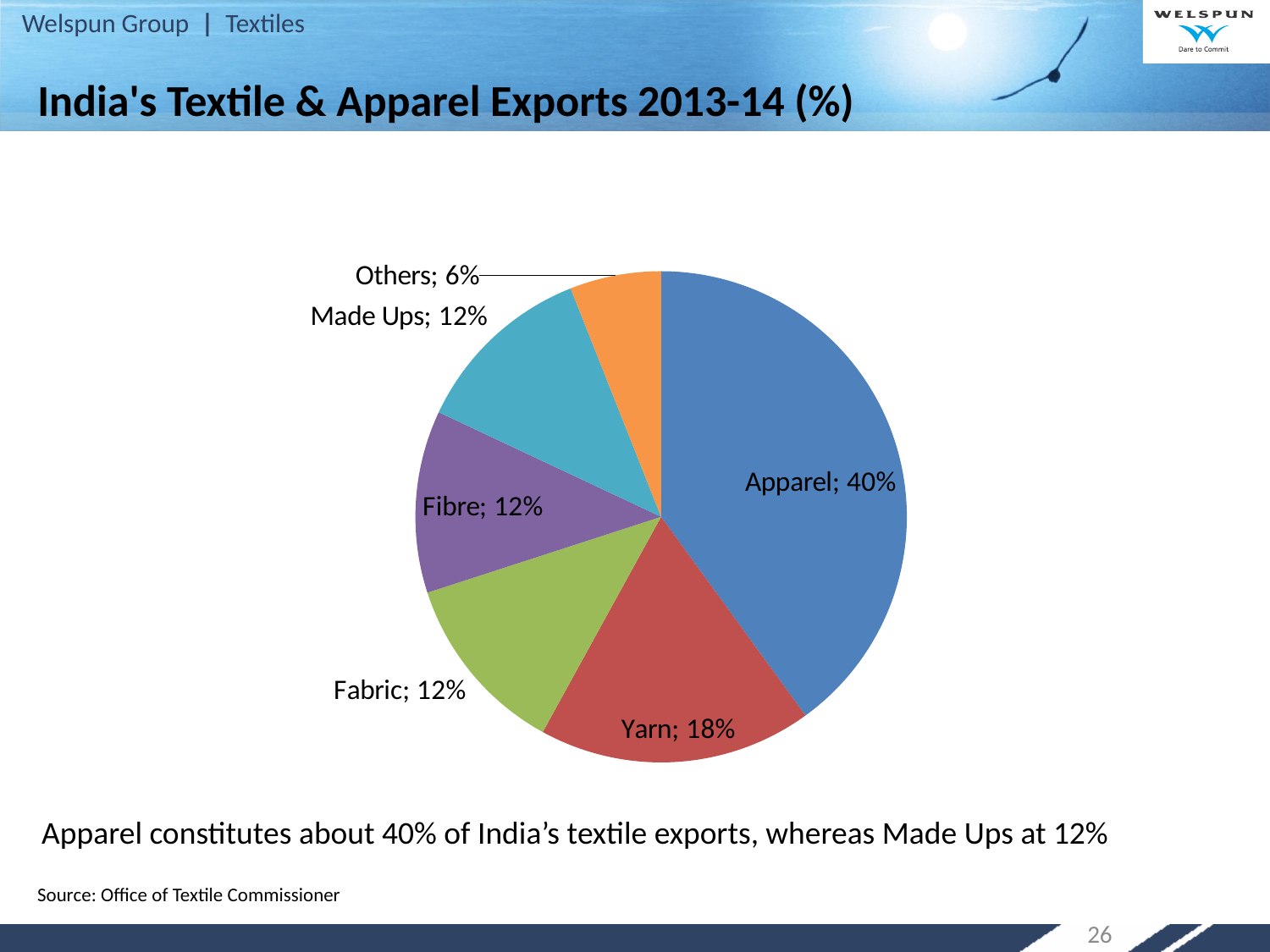
What is the title of the chart on the slide? India's Textile & Apparel Exports 2013-14 (%) What share of exports does Yarn account for? 18% Which category has the smallest share of the pie? Others What share of India's textile and apparel exports in 2013-14 is Apparel? 40% How many categories are shown in the pie chart? 6 What type of chart is shown on the slide? pie chart What is the difference in percentage points between Apparel and Yarn? 22 What share of exports does Others account for? 6% What is the combined share of Fabric, Fibre and Made Ups? 36% Which is larger, the share for Yarn or the share for Fibre? Yarn What share of exports does Made Ups account for? 12% Which category has the largest share of the pie? Apparel